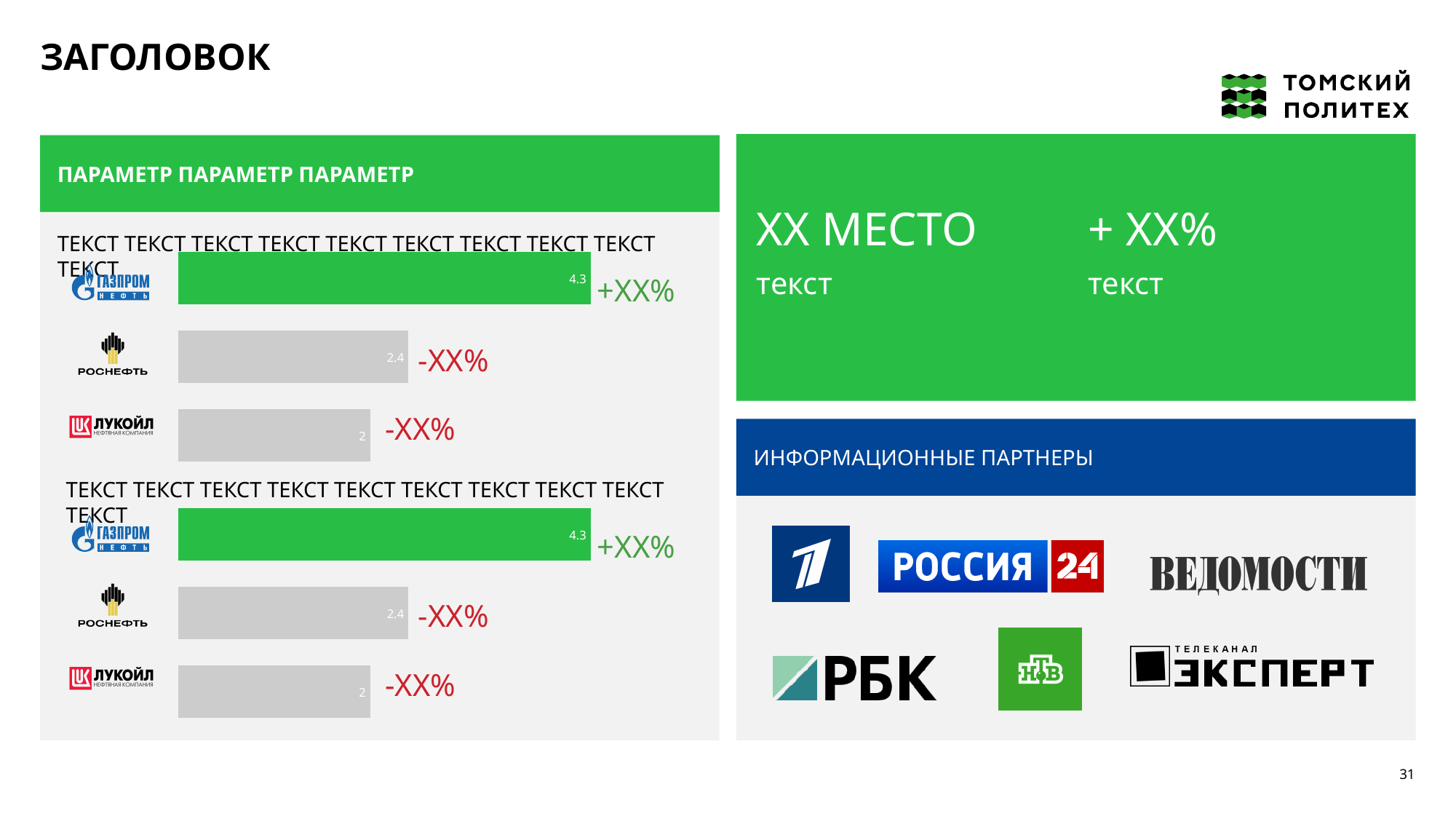
In the upper bar chart on the left panel, what value is shown for Газпром нефть? 4.3 What type of chart is used in the left panel of the slide? Bar chart How many bars does the lower bar chart on the left panel contain? 3 In the upper bar chart on the left panel, which bar is coloured green rather than grey? Газпром нефть In the upper bar chart on the left panel, what value is shown for Лукойл? 2 In the lower bar chart on the left panel, which is larger, the value for Роснефть or the value for Лукойл? Роснефть In the lower bar chart on the left panel, what is the difference between the values for Роснефть and Лукойл? 0.4 In the upper bar chart on the left panel, which company has the lowest value? Лукойл In the lower bar chart on the left panel, what value is shown for Газпром нефть? 4.3 In the upper bar chart on the left panel, which company has the highest value? Газпром нефть In the upper bar chart on the left panel, what value is shown for Роснефть? 2.4 In the upper bar chart on the left panel, what is the difference between the values for Газпром нефть and Роснефть? 1.9